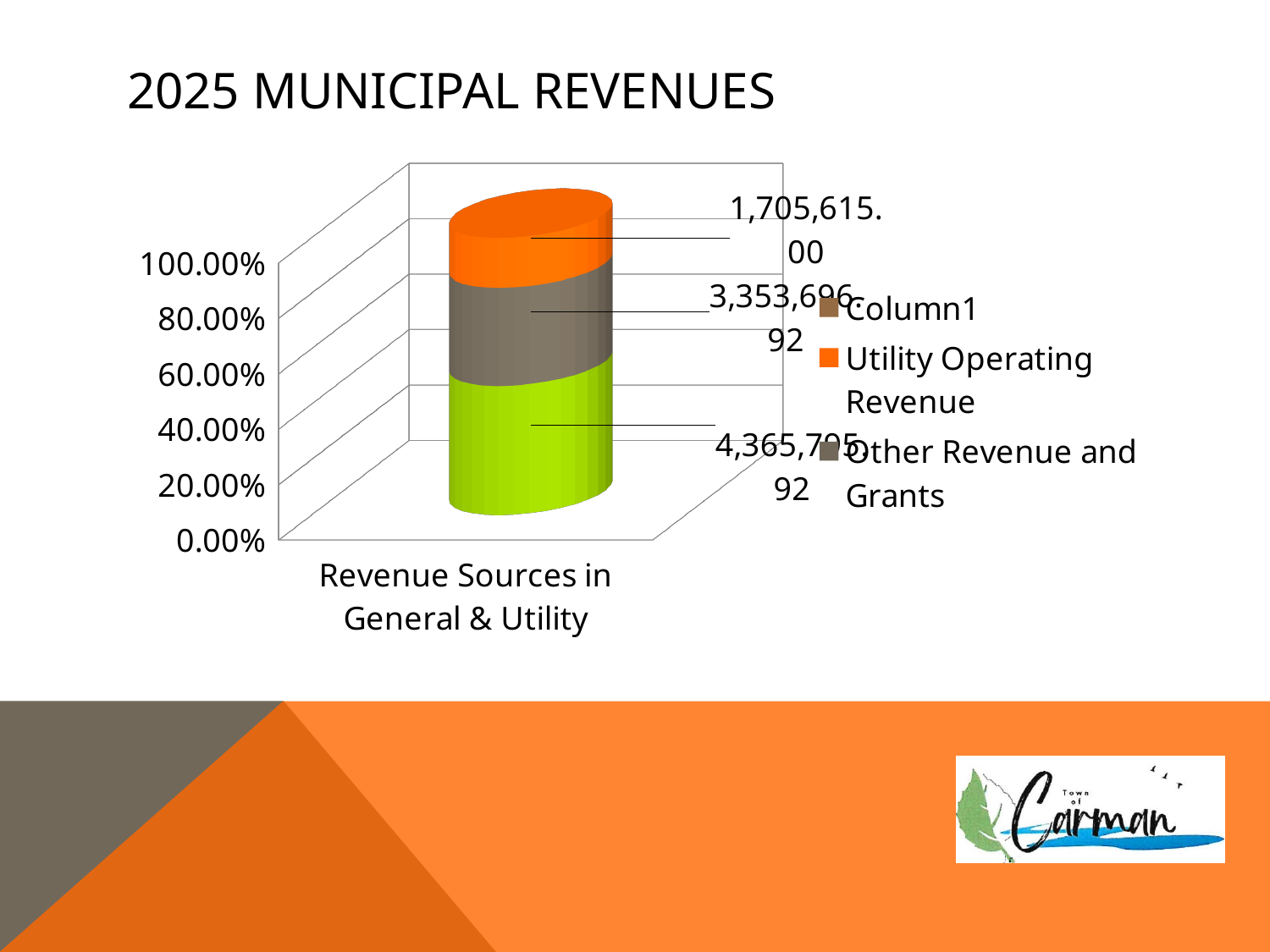
What is the title of the slide's chart? 2025 MUNICIPAL REVENUES What is the data label value for Other Revenue and Grants? 3,353,696.92 What kind of chart is shown on the slide? Stacked bar chart Which segment of the bar has the smallest value: the orange, grey, or green segment? Orange How many series does the chart legend list? 3 Which is larger, Utility Operating Revenue or Other Revenue and Grants? Other Revenue and Grants Which segment of the bar has the largest value: the orange, grey, or green segment? Green What is the difference between Other Revenue and Grants and Utility Operating Revenue? 1,648,081.92 What is the data label value shown on the green segment of the bar? 4,365,795.92 How many categories are shown on the x axis? 1 What is the category label on the x axis? Revenue Sources in General & Utility What is the data label value for Utility Operating Revenue? 1,705,615.00